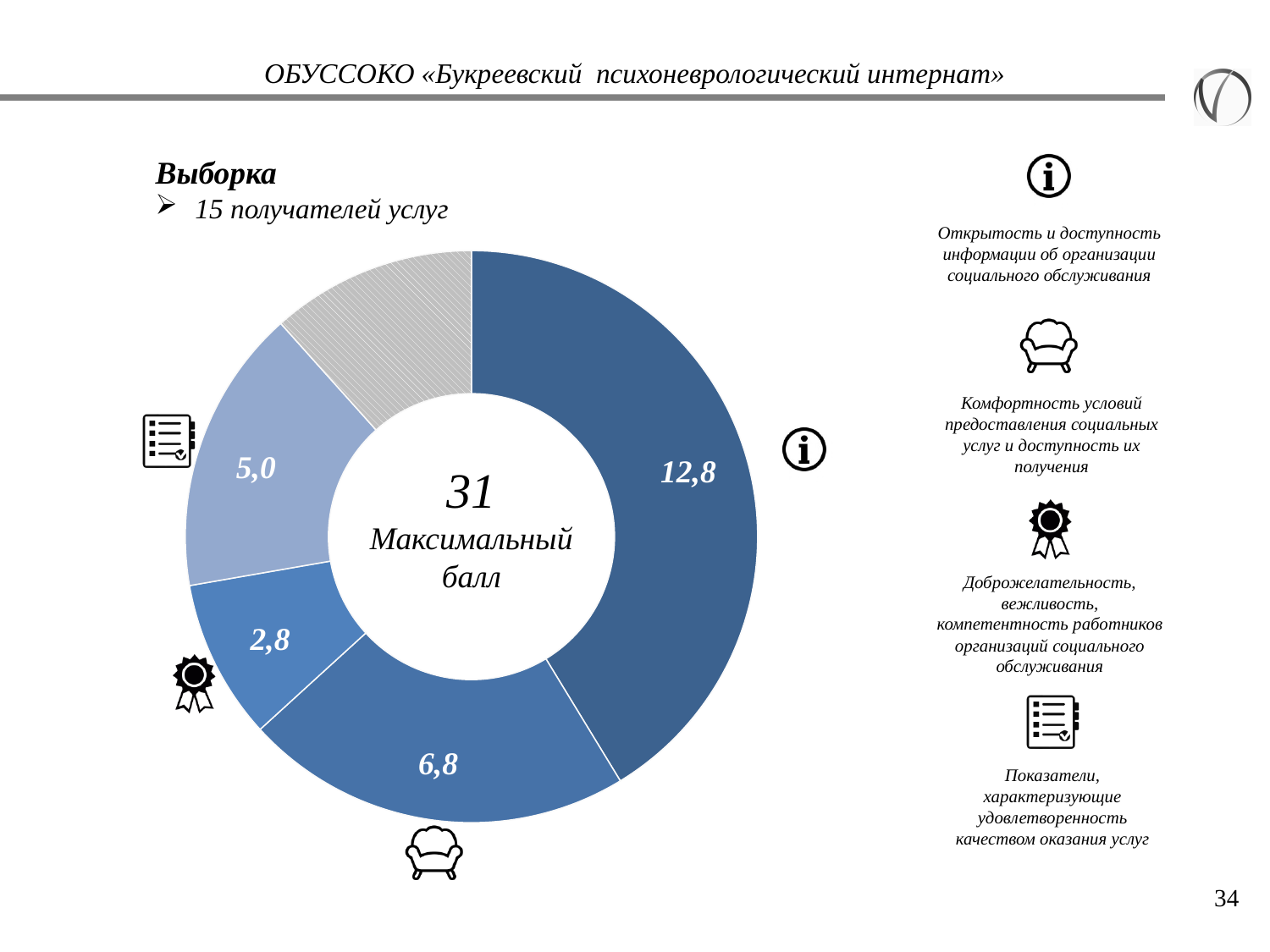
What value is shown for the segment marked with the award icon (Доброжелательность, вежливость, компетентность работников)? 2,8 What kind of chart is shown on the slide? pie chart (donut) What maximum score (Максимальный балл) is shown in the centre of the donut chart? 31 What is the difference between the segment with the armchair icon (6,8) and the segment with the award icon (2,8)? 4,0 What value is shown for the segment marked with the armchair icon (Комфортность условий предоставления социальных услуг и доступность их получения)? 6,8 Which labeled segment has the lowest value? Доброжелательность, вежливость, компетентность работников (2,8) How many segments of the donut chart have a printed data label? 4 What is the difference between the segment with the information icon (12,8) and the segment with the armchair icon (6,8)? 6,0 Which labeled segment has the highest value? Открытость и доступность информации (12,8) What value is shown for the segment marked with the checklist icon (Показатели, характеризующие удовлетворенность качеством оказания услуг)? 5,0 Which is larger: the segment with the checklist icon or the segment with the award icon? the segment with the checklist icon (5,0) What value is shown for the segment marked with the information icon (Открытость и доступность информации об организации социального обслуживания)? 12,8